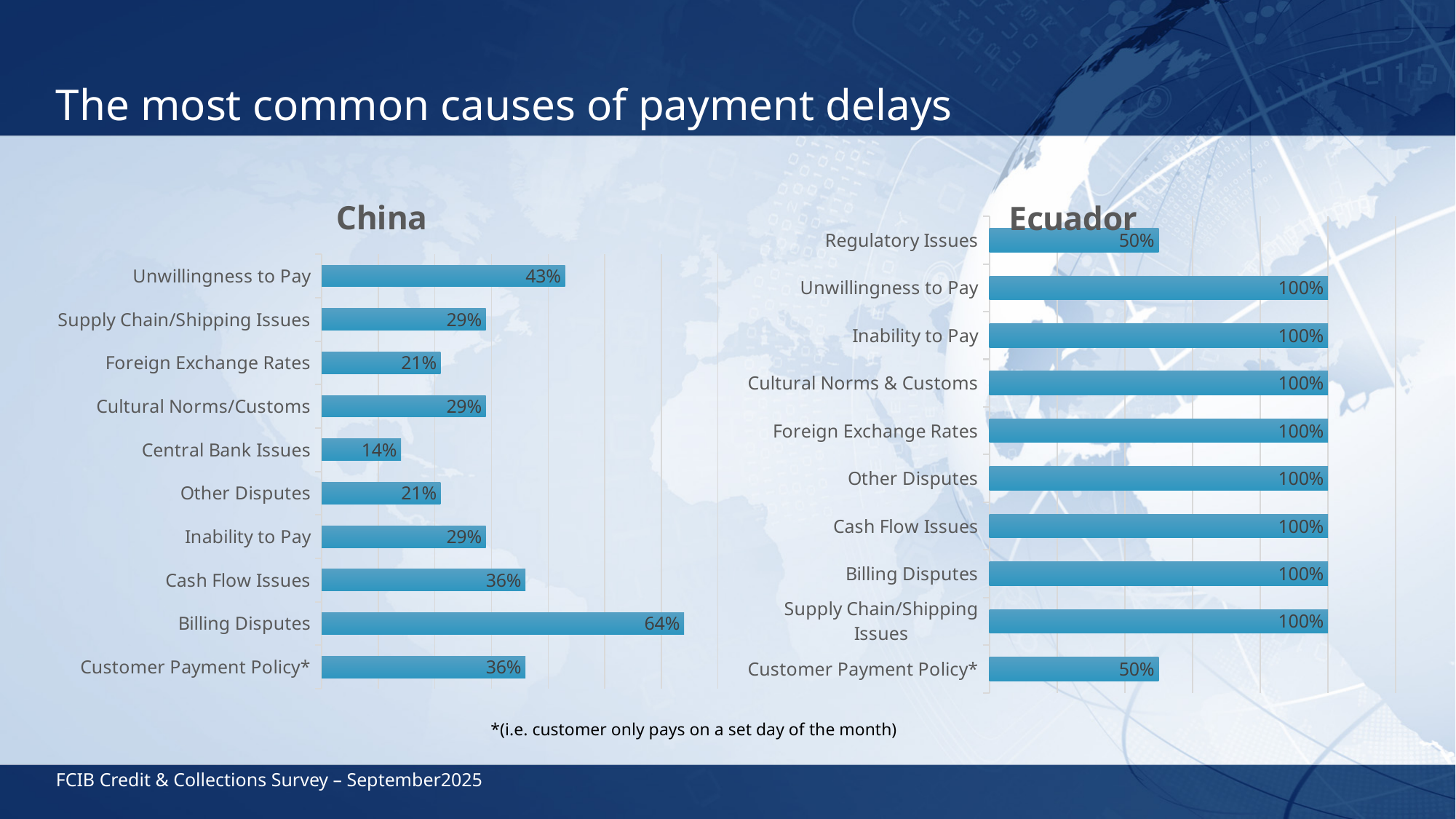
In the China chart, what is the value for Central Bank Issues? 14% In the China chart, which category has the lowest value? Central Bank Issues In the Ecuador chart, what is the value for Regulatory Issues? 50% In the China chart, what is the difference between Billing Disputes and Unwillingness to Pay? 21% What type of chart is the China chart? Bar chart In the China chart, what is the value for Billing Disputes? 64% In the Ecuador chart, what is the difference between Unwillingness to Pay and Regulatory Issues? 50% In the Ecuador chart, what is the value for Customer Payment Policy*? 50% In the China chart, which is larger: Cash Flow Issues or Foreign Exchange Rates? Cash Flow Issues How many categories are shown in the China chart? 10 In the China chart, which category has the highest value? Billing Disputes How many categories are shown in the Ecuador chart? 10